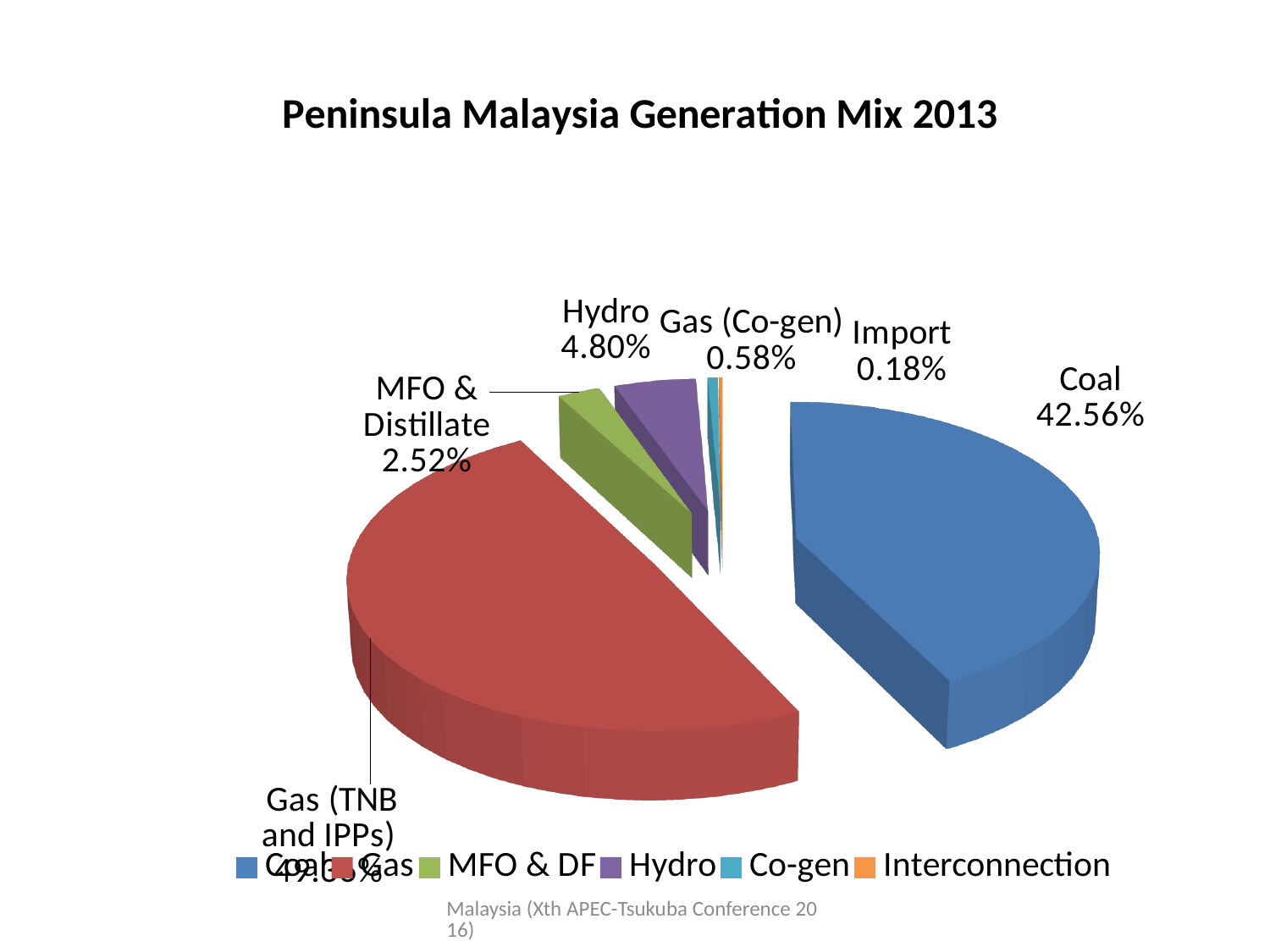
What share of the generation mix does Coal account for? 42.56% How much larger is the Coal share than the Hydro share? 37.76% What share does Import contribute to the generation mix? 0.18% What percentage is shown for Gas (Co-gen)? 0.58% What is the value labelled for MFO & Distillate? 2.52% What percentage is shown for Hydro? 4.80% Which category has the largest slice of the pie? Gas (TNB and IPPs) Which category has the smallest slice of the pie? Import How many slices does the pie chart have? 6 What type of chart is shown on the slide? Pie chart Which is larger, the Hydro share or the MFO & Distillate share? Hydro What is the title of the chart? Peninsula Malaysia Generation Mix 2013